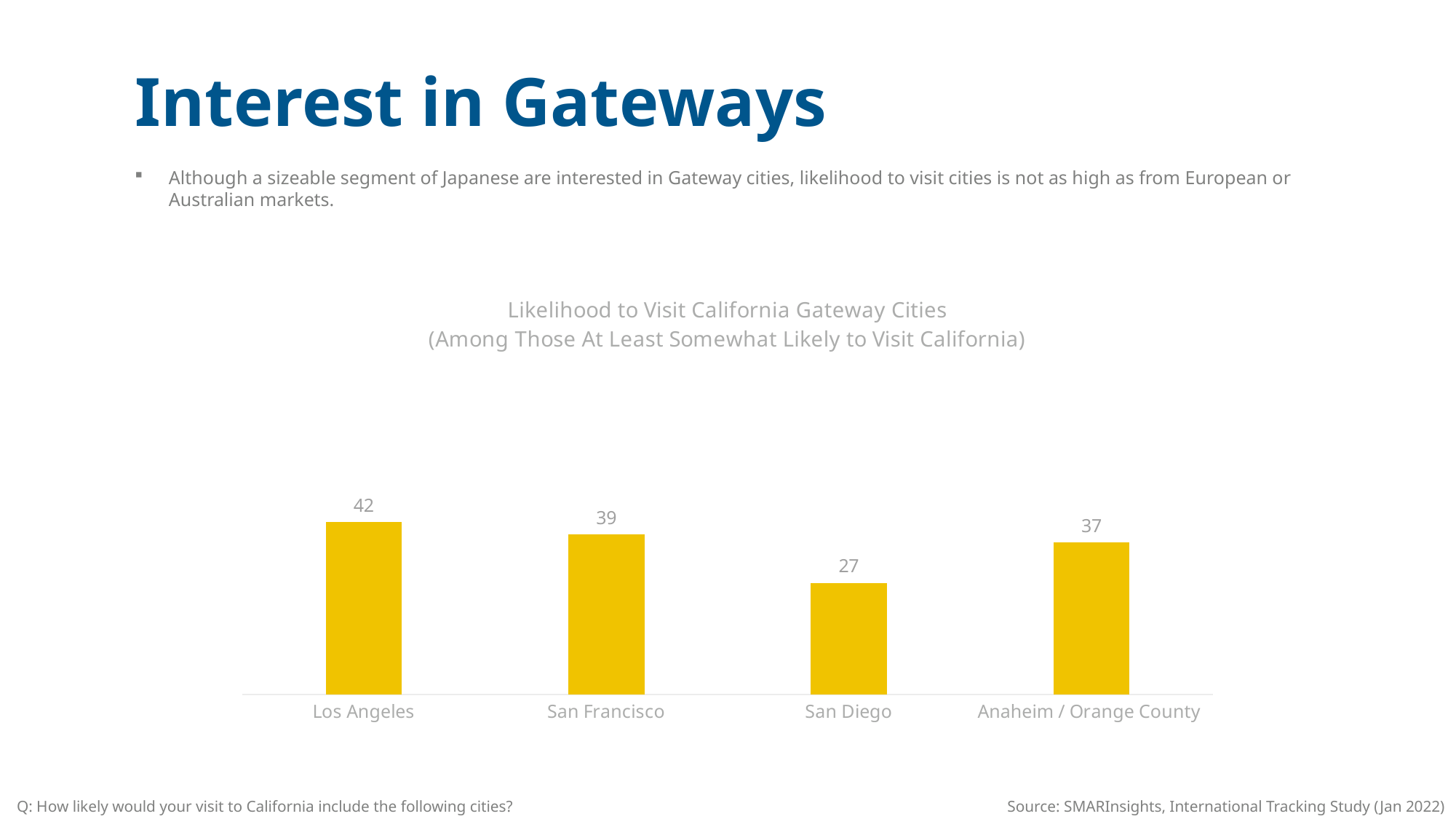
What is the value for Anaheim / Orange County? 37 What kind of chart is shown on the slide? Bar chart What is the title of the chart? Likelihood to Visit California Gateway Cities (Among Those At Least Somewhat Likely to Visit California) What is the value for San Diego? 27 What is the difference between the values for Los Angeles and San Diego? 15 How many cities are shown in the chart? 4 Which city has the lowest value? San Diego What is the value for San Francisco? 39 What is the value for Los Angeles? 42 What is the difference between the values for San Francisco and Anaheim / Orange County? 2 Which city has the highest value? Los Angeles Which is larger, the value for San Francisco or the value for San Diego? San Francisco